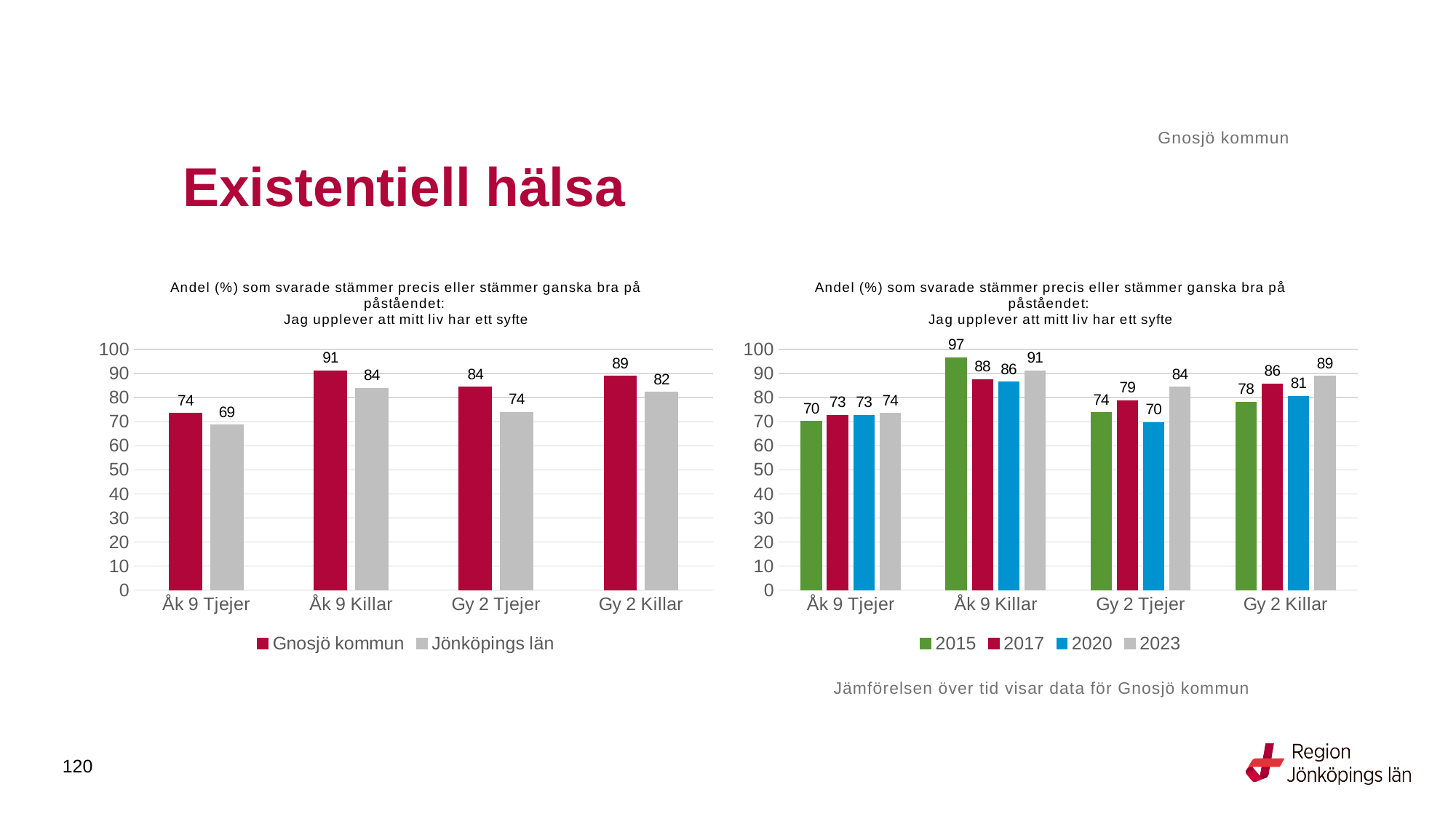
In the left chart, what is the difference between Gnosjö kommun and Jönköpings län for Gy 2 Tjejer? 10 In the right chart, what is the value for 2020 for Gy 2 Tjejer? 70 What kind of chart is the left chart? Bar chart In the right chart, which is larger for Gy 2 Killar: 2017 or 2020? 2017 In the right chart, which category has the highest value for 2023? Åk 9 Killar In the left chart, what is the value for Gnosjö kommun for Åk 9 Killar? 91 In the left chart, what is the value for Jönköpings län for Gy 2 Tjejer? 74 In the left chart, which category has the lowest value for Jönköpings län? Åk 9 Tjejer In the right chart, what is the difference between the 2015 and 2023 values for Gy 2 Killar? 11 In the right chart, how many series does the legend list? 4 In the left chart, how many series does the legend list? 2 In the right chart, what is the value for 2015 for Åk 9 Killar? 97